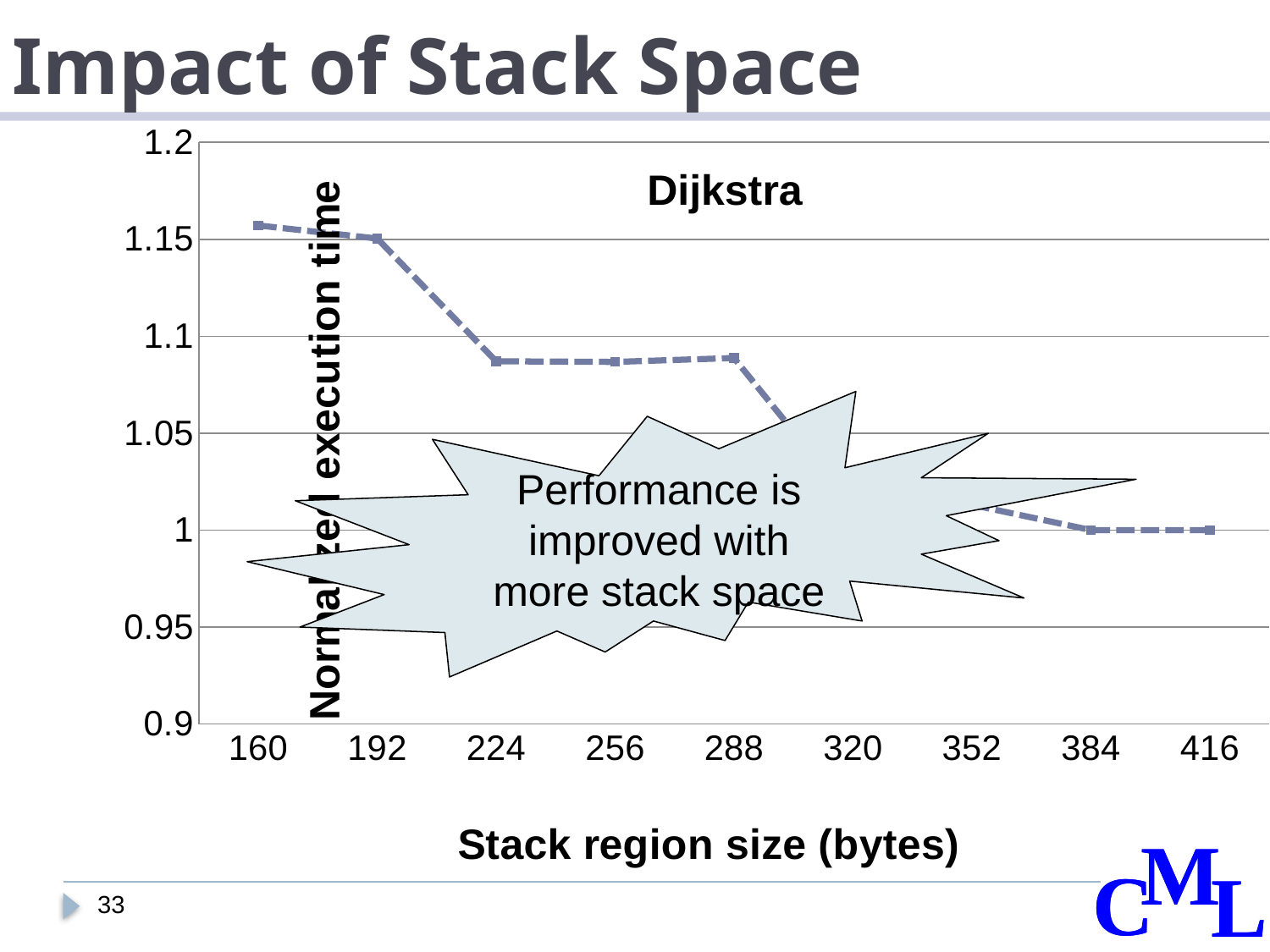
What is the label of the x axis? Stack region size (bytes) What kind of chart is shown on the slide? line chart Is the normalized execution time at a stack region size of 224 bytes greater or less than 1.1? less How many stack region sizes are labelled on the x axis? 9 Does the normalized execution time rise or fall as the stack region size increases from 160 to 416 bytes? fall Is the normalized execution time at a stack region size of 224 bytes greater or less than 1.05? greater Which has the higher normalized execution time: a stack region size of 288 bytes or 384 bytes? 288 Is the normalized execution time at a stack region size of 160 bytes greater or less than 1.1? greater Which has the higher normalized execution time: a stack region size of 160 bytes or 224 bytes? 160 What is the title of the chart? Dijkstra